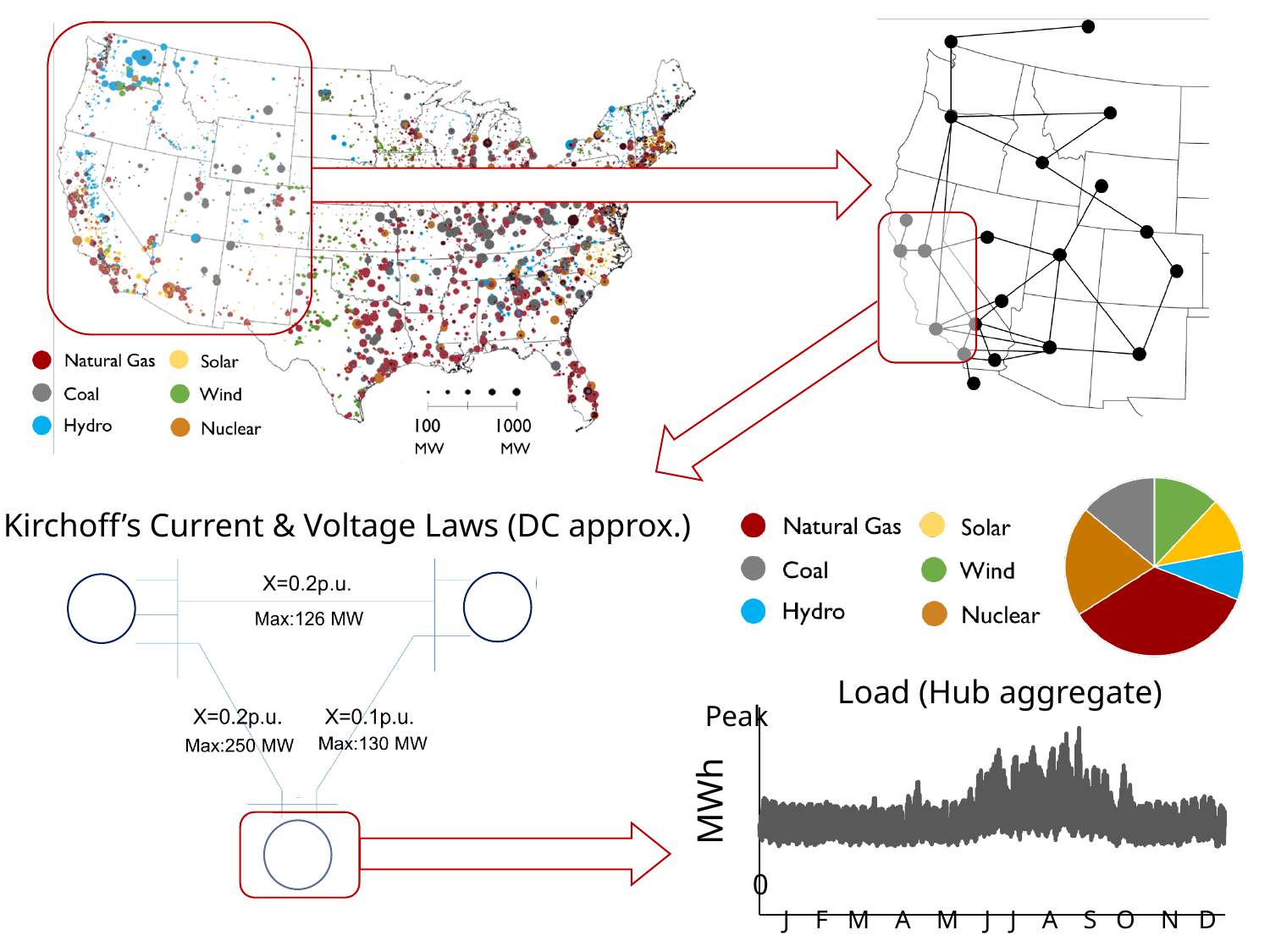
How many fuel types does the legend next to the pie chart list? 6 In the pie chart, which fuel type has the largest slice? Natural Gas What kind of chart is the chart in the upper right of the lower half of the slide, next to the fuel-type legend? pie chart In the 'Load (Hub aggregate)' chart, in which part of the year does the load reach its highest values? Summer (around July to September) In the pie chart, which slice is larger: Natural Gas or Coal? Natural Gas In the pie chart, which fuel type has the smallest slice? Hydro In the 'Load (Hub aggregate)' chart, is the load higher in August or in February? August In the 'Load (Hub aggregate)' chart, what unit is shown on the y-axis? MWh In the pie chart, which slice is larger: Nuclear or Hydro? Nuclear What is the title of the chart in the bottom right of the slide? Load (Hub aggregate) How many months are labelled along the x-axis of the 'Load (Hub aggregate)' chart? 12 Which colour represents Coal in the pie chart legend? Gray